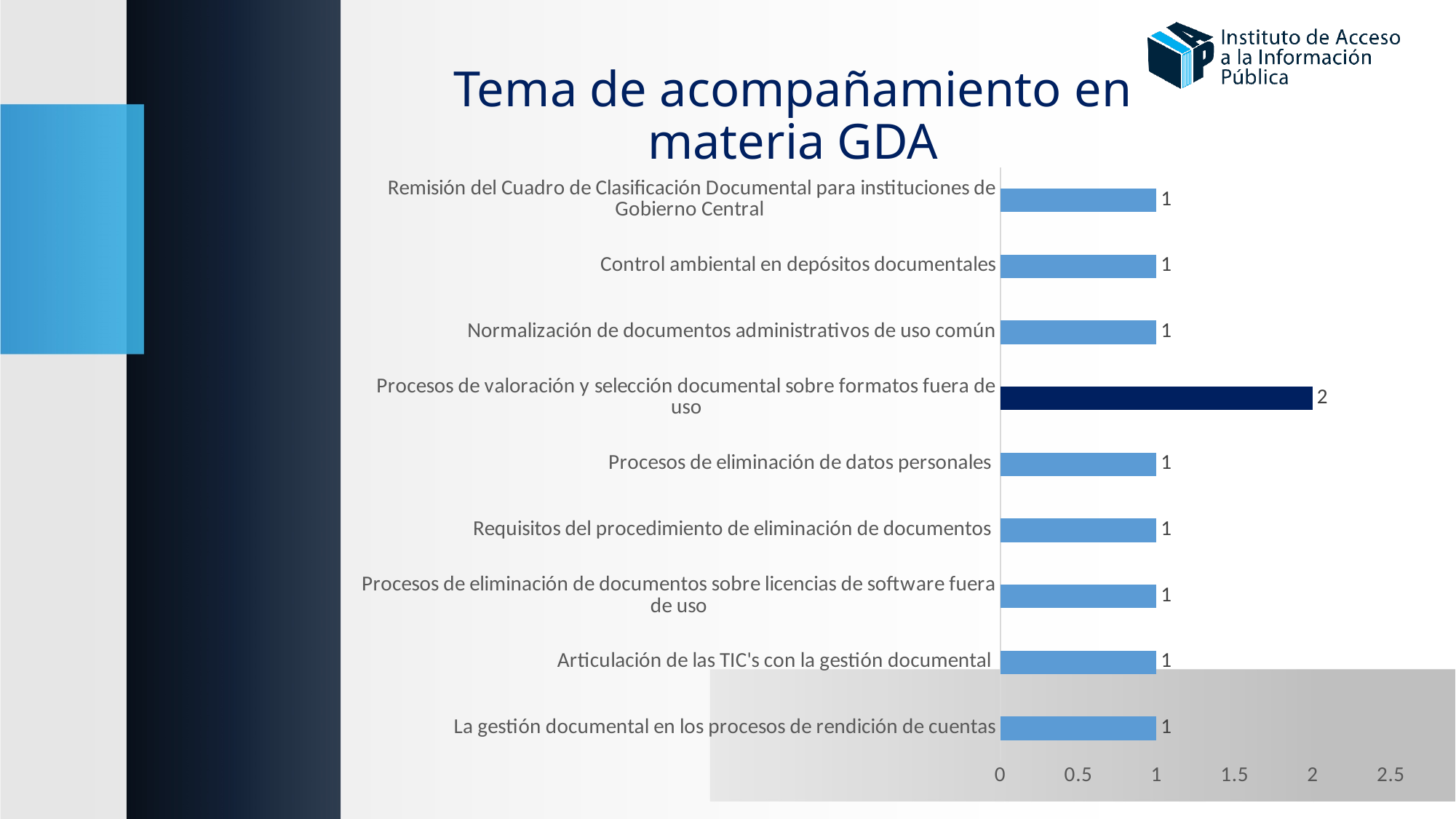
What is the value for "La gestión documental en los procesos de rendición de cuentas"? 1 What type of chart is shown on the slide? bar chart How many categories have a value of 1? 8 How many categories are shown in the chart? 9 What is the highest value shown on the x axis? 2.5 Which is larger: the value for "Procesos de valoración y selección documental sobre formatos fuera de uso" or the value for "Articulación de las TIC's con la gestión documental"? Procesos de valoración y selección documental sobre formatos fuera de uso Is the value for "Requisitos del procedimiento de eliminación de documentos" greater or less than 1.5? less What is the difference between the value for "Procesos de valoración y selección documental sobre formatos fuera de uso" and the value for "Procesos de eliminación de datos personales"? 1 What is the value for "Procesos de valoración y selección documental sobre formatos fuera de uso"? 2 What is the title of the chart? Tema de acompañamiento en materia GDA Which category has the highest value? Procesos de valoración y selección documental sobre formatos fuera de uso What is the value for "Control ambiental en depósitos documentales"? 1